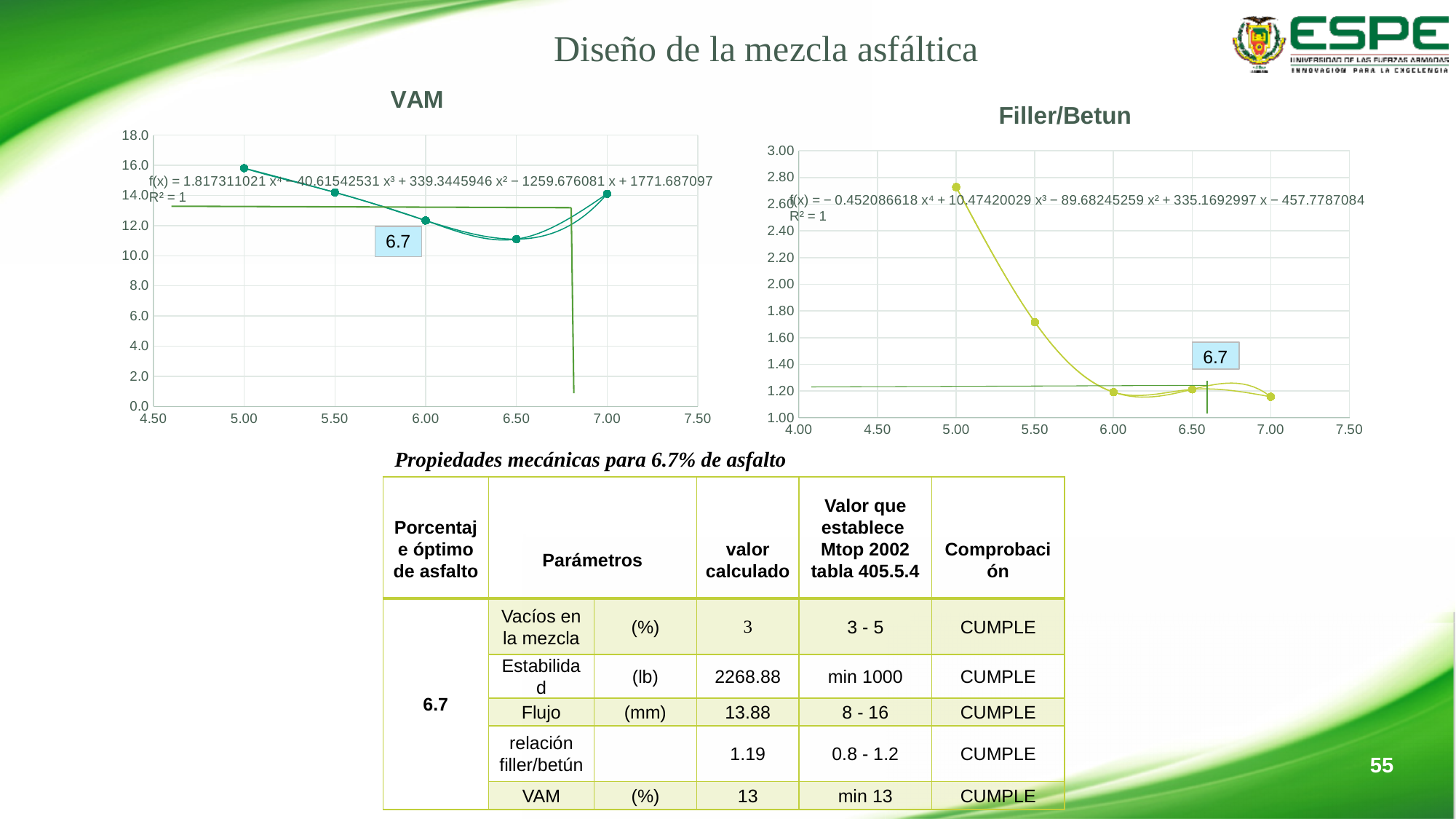
On the Filler/Betun chart, is the value at x = 5.50 greater or less than 2.00? less On the Filler/Betun chart, at which x value is the plotted value highest? 5.00 What kind of chart is the VAM chart? Line chart On the VAM chart, is the value at x = 6.50 greater or less than 12.0? less How many data points are plotted on the Filler/Betun chart? 5 On the VAM chart, at which x value is the plotted value lowest? 6.50 How many data points are plotted on the VAM chart? 5 What R² value is shown for the trendline on the VAM chart? R² = 1 On the Filler/Betun chart, do the values rise or fall from x = 5.00 to x = 6.00? fall On the VAM chart, is the value at x = 5.00 greater or less than 14.0? greater On the Filler/Betun chart, which has the larger value: x = 5.50 or x = 6.50? 5.50 On the VAM chart, at which x value is the plotted value highest? 5.00